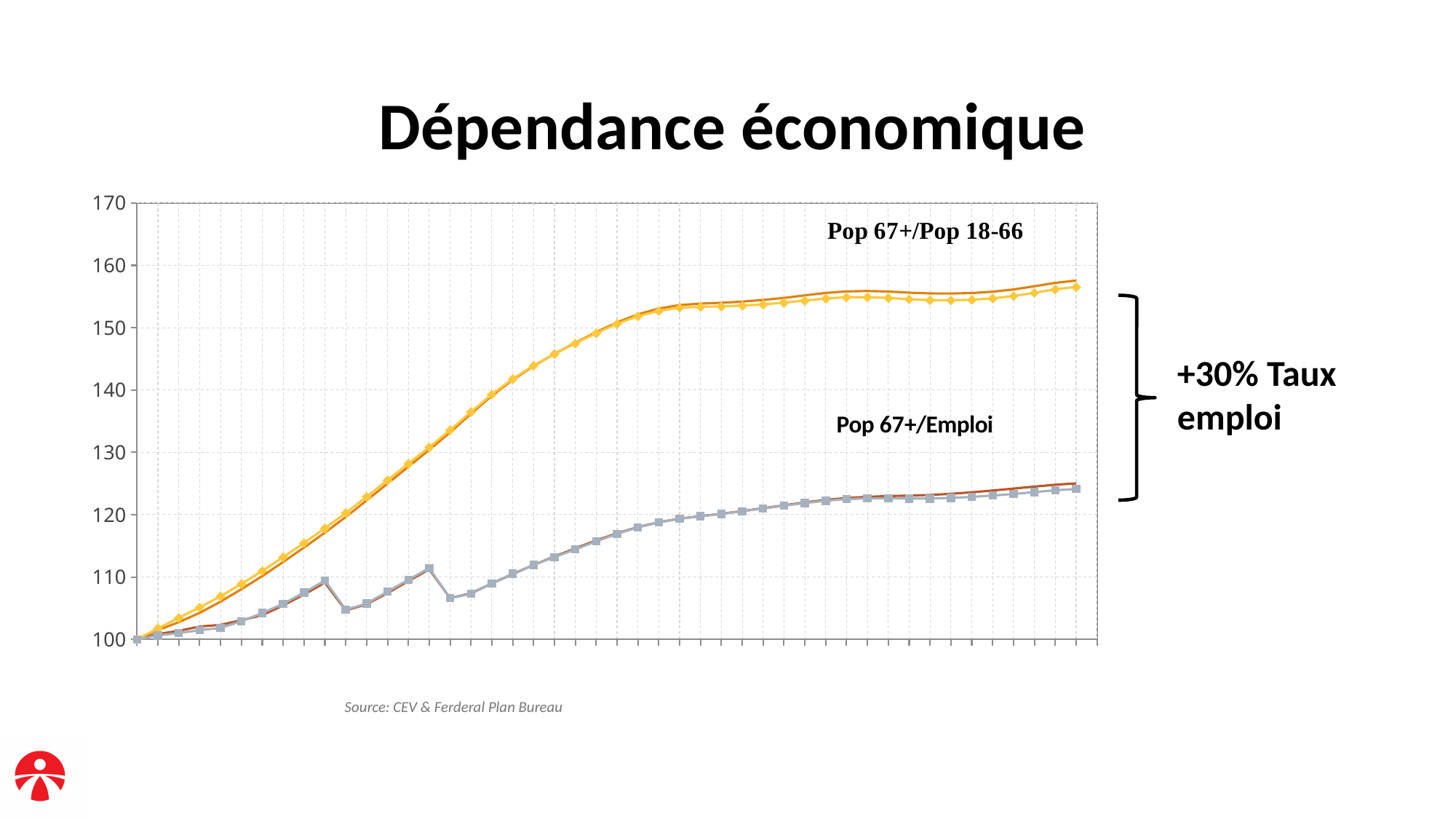
Which series is higher at the right end of the chart, Pop 67+/Pop 18-66 or Pop 67+/Emploi? Pop 67+/Pop 18-66 Is the final value of the Pop 67+/Pop 18-66 series greater or less than 160? less Does the Pop 67+/Pop 18-66 series rise or fall overall along the x axis? rise Is the final value of the Pop 67+/Emploi series greater or less than 130? less Is the final value of the Pop 67+/Pop 18-66 series greater or less than 150? greater How many series are labelled on the chart? 2 At what value do both series start at the left of the chart? 100 Does the Pop 67+/Emploi series rise or fall overall along the x axis? rise What is the title of the slide's chart? Dépendance économique What kind of chart is shown on the slide? line chart What annotation is written next to the bracket on the right of the chart? +30% Taux emploi